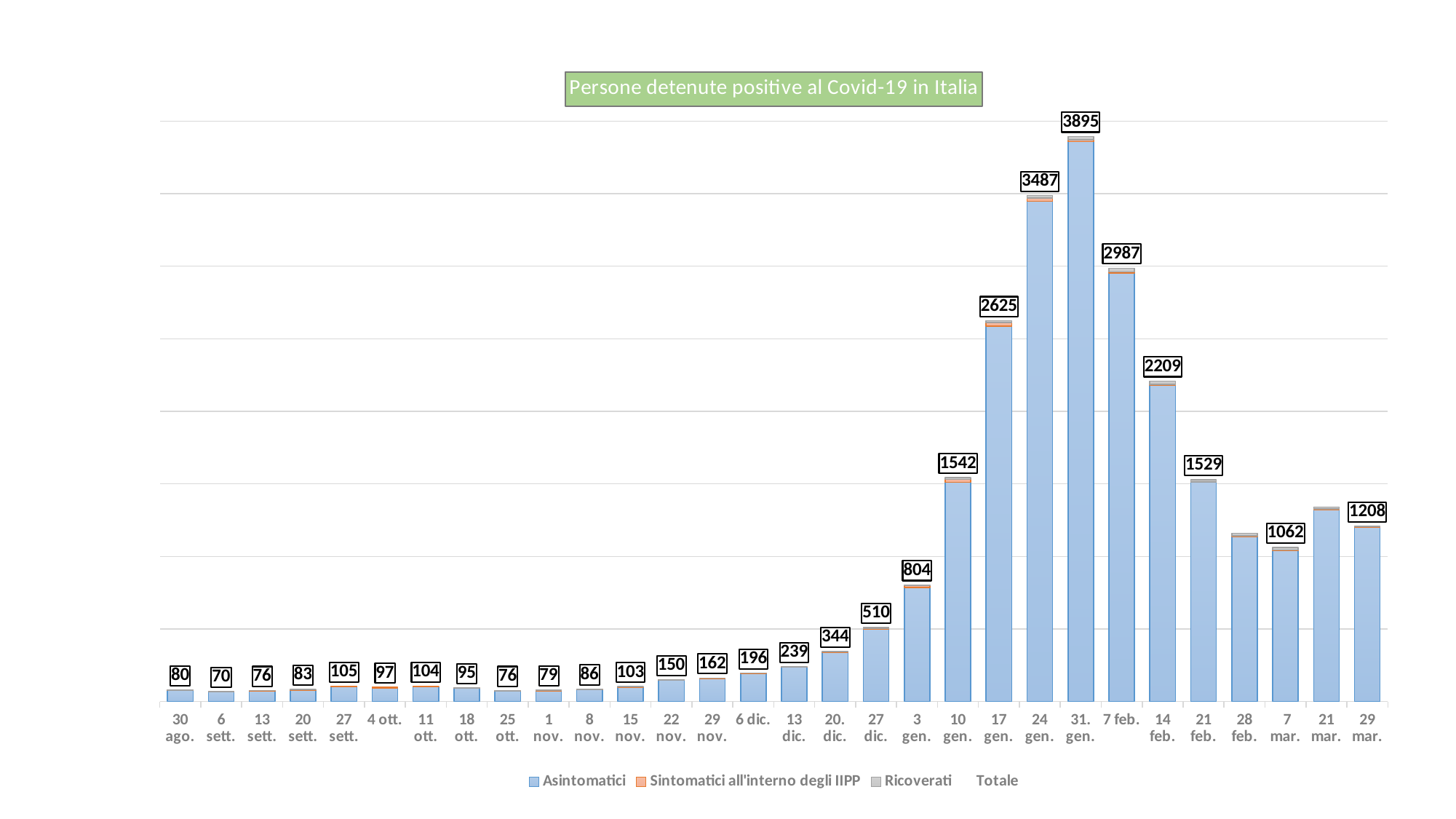
How many dates are shown on the x axis? 30 Which date has the highest total? 31 gen. What is the total value shown for 29 mar.? 1208 Which is larger, the total for 7 feb. or the total for 14 feb.? 7 feb. What is the title of the chart? Persone detenute positive al Covid-19 in Italia Which date has the lowest total? 6 sett. What is the total value shown for 10 gen.? 1542 What is the total value shown for 31 gen.? 3895 How many entries does the legend list? 4 What kind of chart is this? Stacked bar chart What is the total value shown for 30 ago.? 80 What is the difference between the totals for 31 gen. and 24 gen.? 408